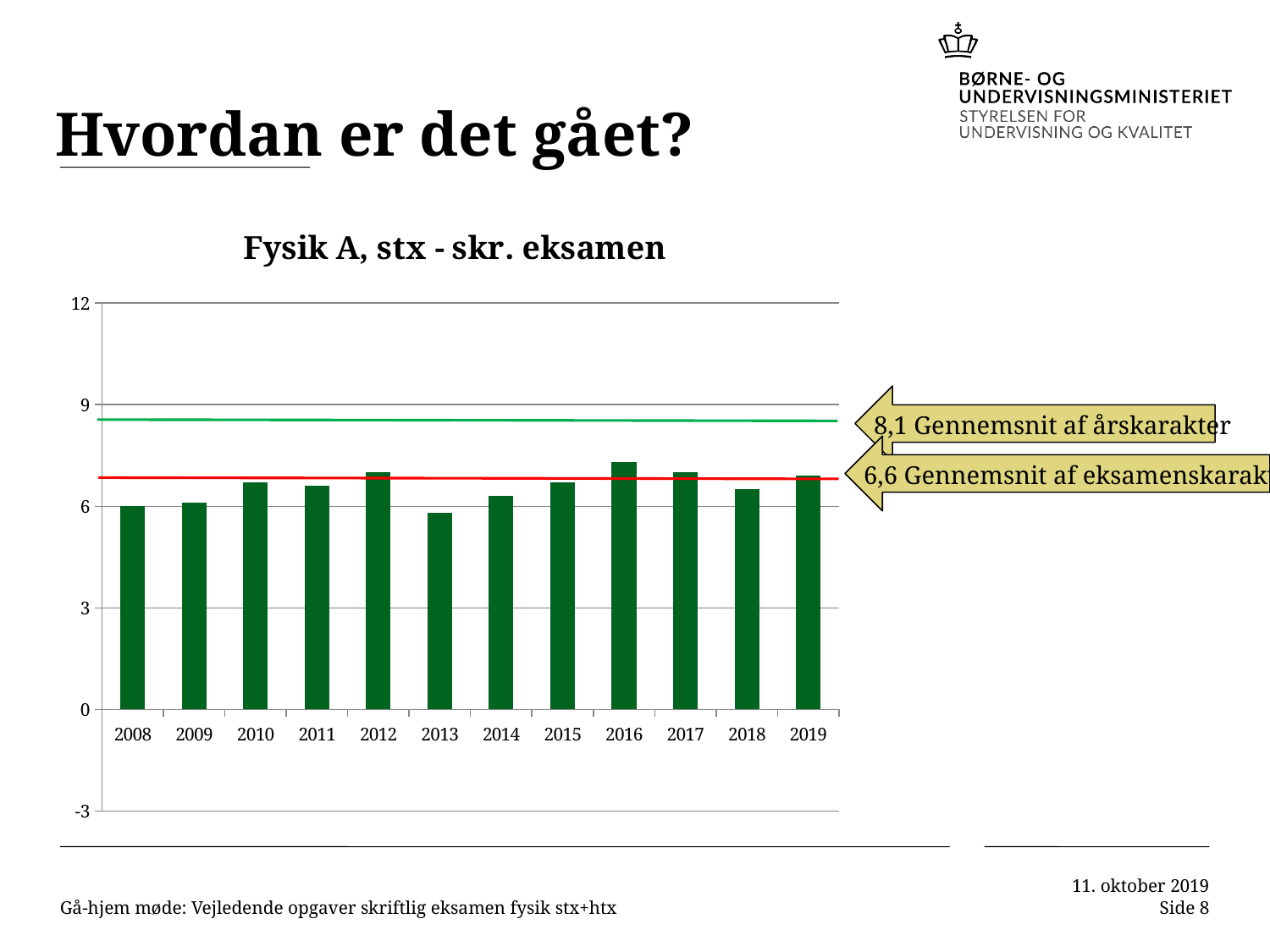
Is the value for 2012 greater or less than 9? less What kind of chart is shown on the slide? bar chart Which is larger, the bar for 2016 or the bar for 2013? 2016 Is the value for 2016 greater or less than 6? greater Which is larger, the bar for 2012 or the bar for 2008? 2012 What value does the red horizontal line (Gennemsnit af eksamenskarakter) represent? 6,6 Which year has the lowest bar in the chart? 2013 How many years (bars) are shown on the x axis of the chart? 12 What value does the green horizontal line (Gennemsnit af årskarakter) represent? 8,1 What is the title of the chart? Fysik A, stx - skr. eksamen Is the value for 2013 greater or less than 6? less Which year has the highest bar in the chart? 2016